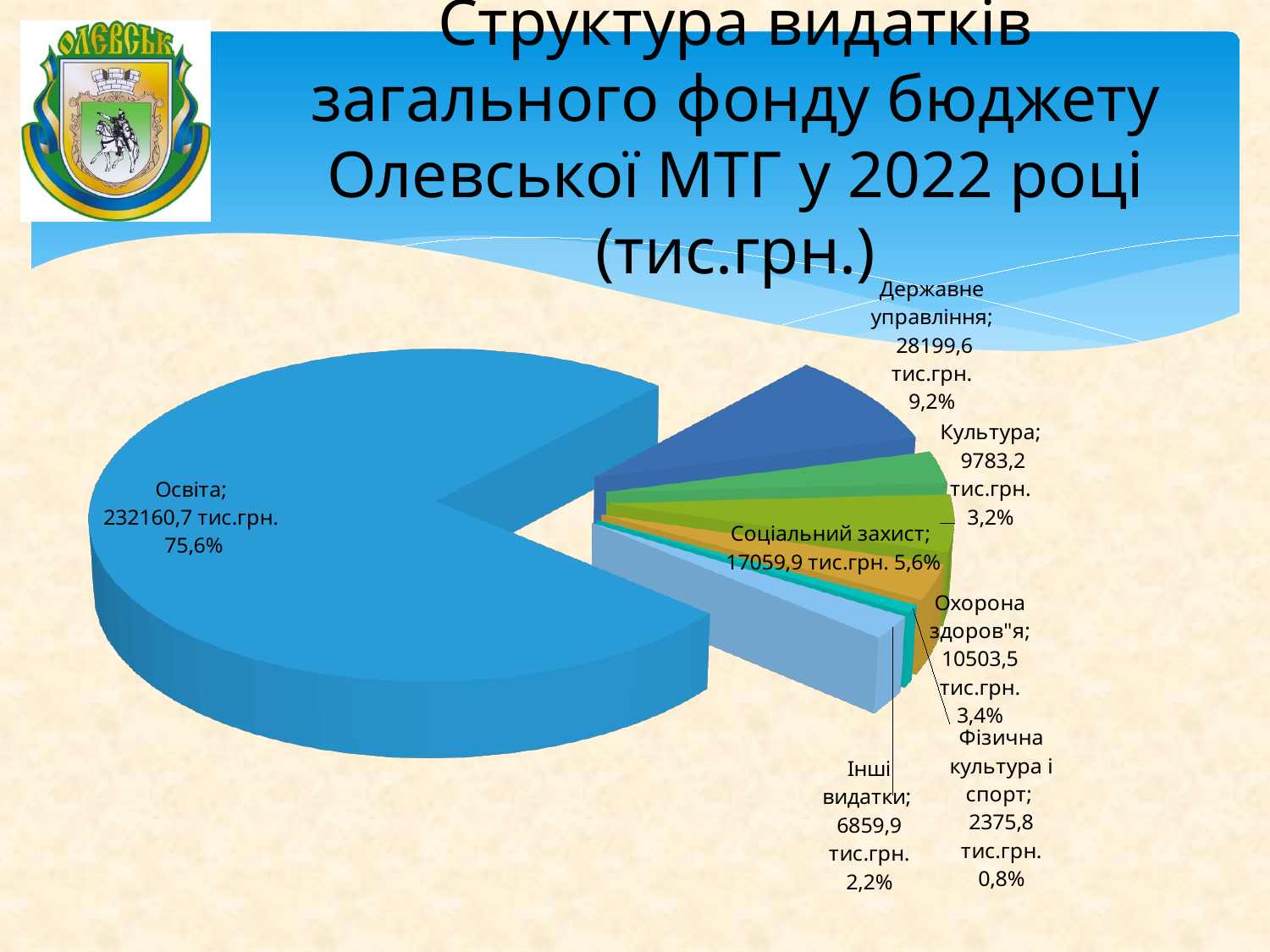
What share of the pie does Соціальний захист represent? 5,6% What is the difference in percentage share between Державне управління and Соціальний захист? 3,6% What is the value for Охорона здоров"я? 10503,5 тис.грн. Which is larger: Культура or Охорона здоров"я? Охорона здоров"я Which category has the smallest share of the pie? Фізична культура і спорт What is the value for Державне управління? 28199,6 тис.грн. What share of the pie does Освіта represent? 75,6% What type of chart is shown on the slide? Pie chart Which category has the largest share of the pie? Освіта How many categories (slices) does the pie chart show? 7 What is the title of the chart? Структура видатків загального фонду бюджету Олевської МТГ у 2022 році (тис.грн.) What is the value for Освіта? 232160,7 тис.грн.